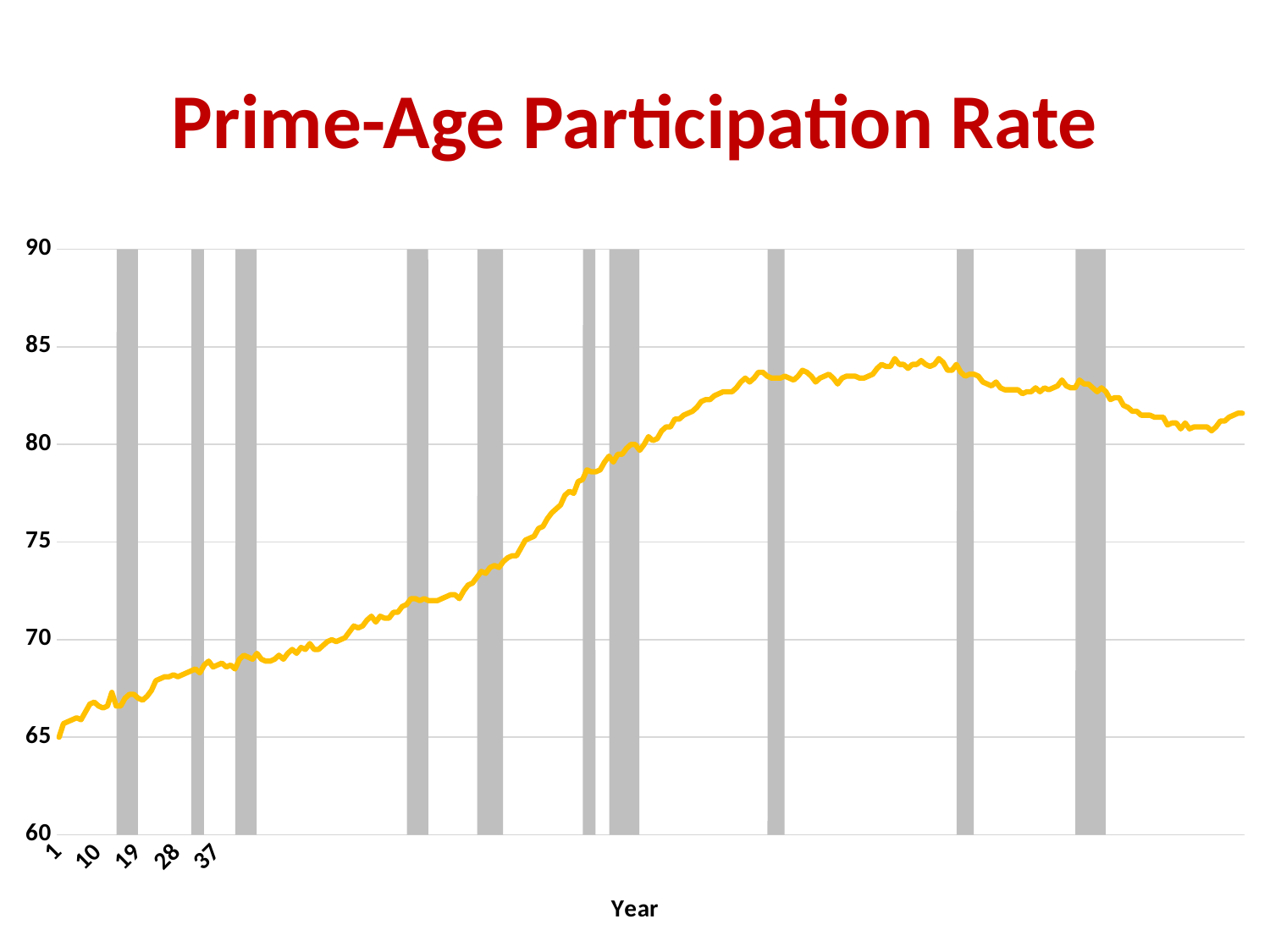
Is the value at year 37 greater or less than 65? greater What is the highest value shown on the y axis? 90 What is the label on the x axis of the chart? Year Is the value at the end of the line greater or less than 80? greater Is the value at the start of the line (year 1) greater or less than 70? less What kind of chart is shown on the slide? Line chart What is the title of the chart? Prime-Age Participation Rate Does the line generally rise or fall from year 1 up to its peak? rise After reaching its peak, does the line rise or fall toward the end of the series? fall Which is larger, the value at the start of the line or the value at the end of the line? the value at the end